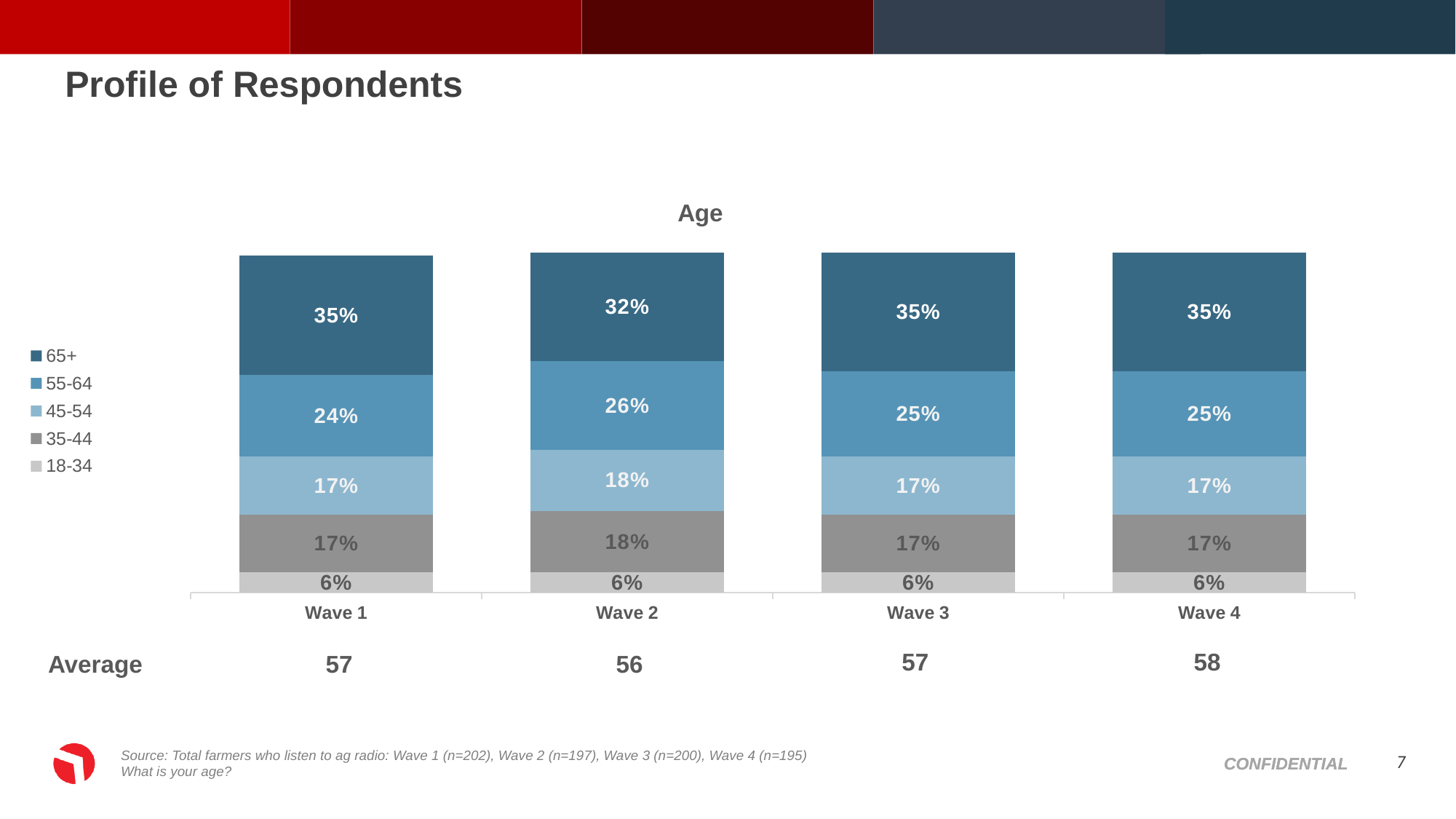
What percentage of Wave 2 respondents are aged 65+? 32% Which wave has the lowest share of respondents aged 65+? Wave 2 Is the 55-64 share larger in Wave 2 or in Wave 1? Wave 2 Which wave has the highest share of respondents aged 55-64? Wave 2 What percentage of Wave 4 respondents are aged 18-34? 6% How many age groups does the legend list? 5 What percentage of Wave 1 respondents are aged 55-64? 24% What percentage of Wave 3 respondents are aged 45-54? 17% What is the difference between the 65+ share in Wave 1 and the 65+ share in Wave 2? 3% What kind of chart is shown on the slide? Stacked bar chart What is the title of the chart? Age How many waves are shown on the x axis of the chart? 4